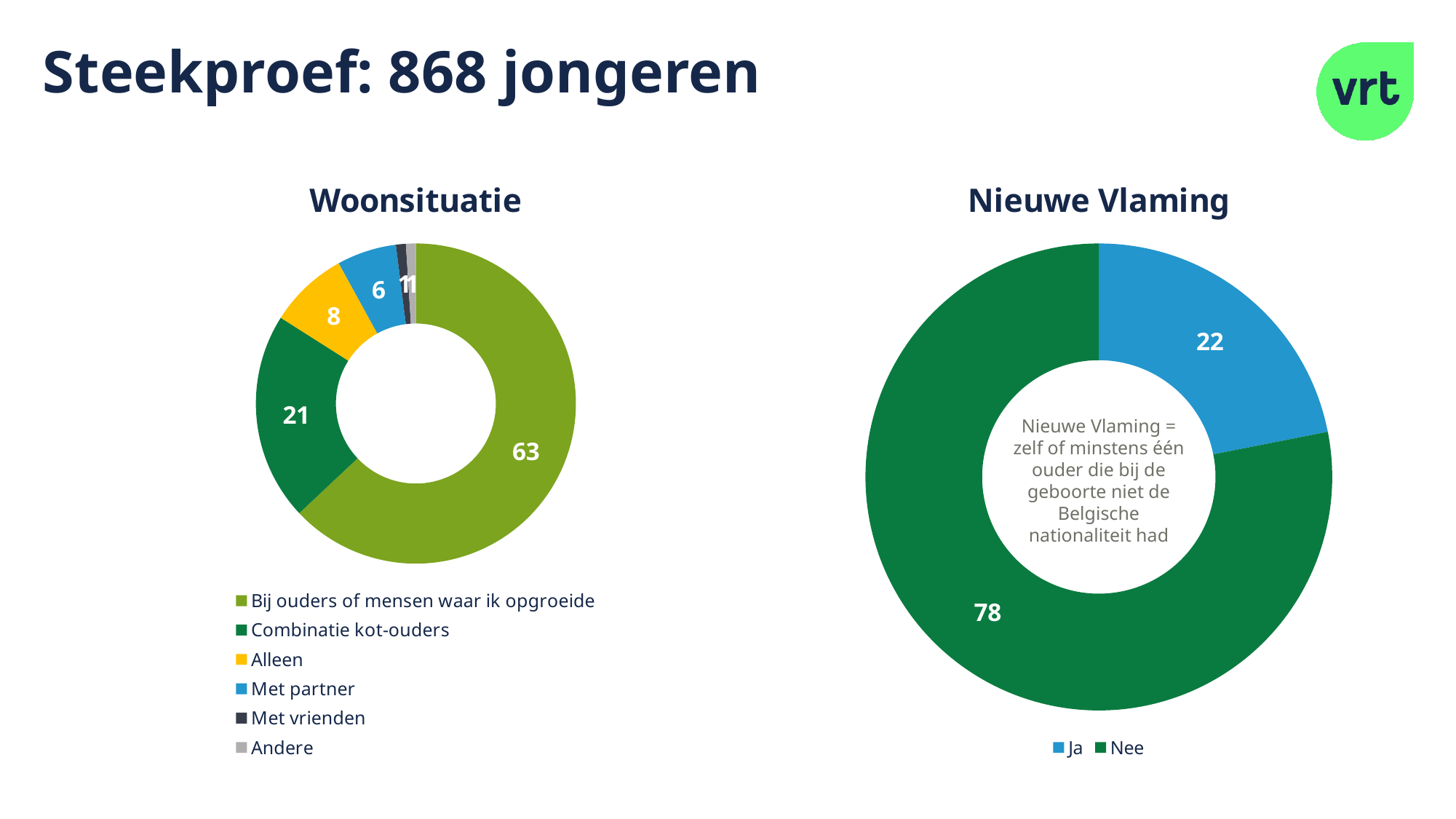
In the 'Woonsituatie' chart, what is the difference between 'Bij ouders of mensen waar ik opgroeide' and 'Combinatie kot-ouders'? 42 How many categories does the legend of the 'Woonsituatie' chart list? 6 In the 'Nieuwe Vlaming' chart, what is the value for 'Ja'? 22 What kind of chart is the 'Nieuwe Vlaming' chart? Doughnut chart In the 'Woonsituatie' chart, what is the value for 'Combinatie kot-ouders'? 21 In the 'Woonsituatie' chart, what is the value for 'Met partner'? 6 In the 'Woonsituatie' chart, what is the value for 'Bij ouders of mensen waar ik opgroeide'? 63 In the 'Nieuwe Vlaming' chart, what is the value for 'Nee'? 78 In the 'Woonsituatie' chart, which category has the highest value? Bij ouders of mensen waar ik opgroeide In the 'Woonsituatie' chart, what is the value for 'Alleen'? 8 In the 'Woonsituatie' chart, which is larger: 'Alleen' or 'Met partner'? Alleen In the 'Nieuwe Vlaming' chart, what is the difference between 'Nee' and 'Ja'? 56